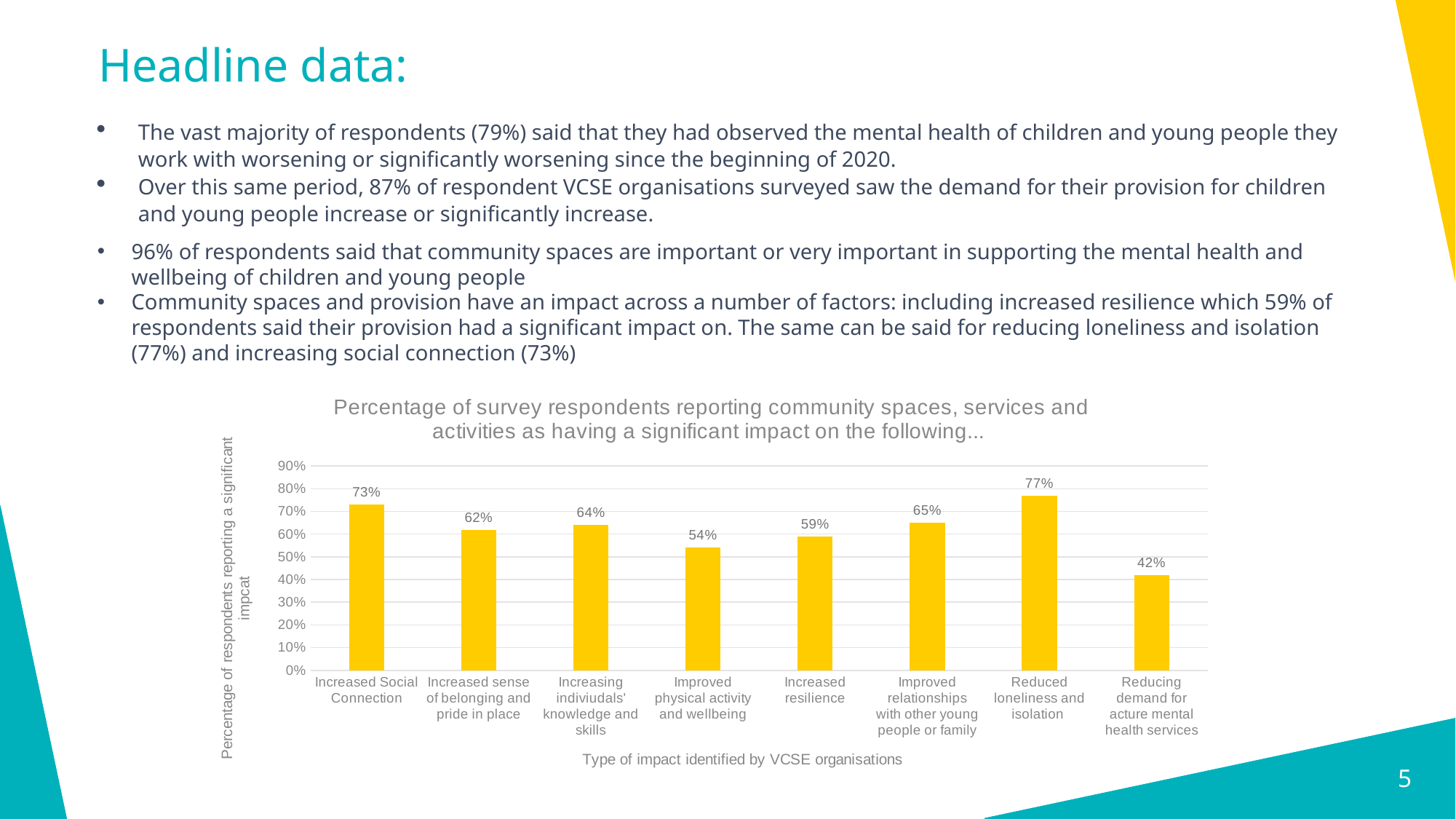
What is the difference between the values for Reduced loneliness and isolation and Improved physical activity and wellbeing? 23% Which type of impact has the highest percentage in the chart? Reduced loneliness and isolation Is the value for Increasing indiviudals' knowledge and skills greater or less than 60%? greater What is the label of the x axis of the chart? Type of impact identified by VCSE organisations What colour are the bars in the chart? Yellow Which type of impact has the lowest percentage in the chart? Reducing demand for acture mental health services What is the value shown for Increased resilience? 59% Which is larger: the value for Increased sense of belonging and pride in place or the value for Improved relationships with other young people or family? Improved relationships with other young people or family What percentage is shown for Reducing demand for acture mental health services? 42% What kind of chart is shown on the slide? Bar chart How many types of impact are shown in the chart? 8 What percentage of respondents reported a significant impact on Increased Social Connection? 73%